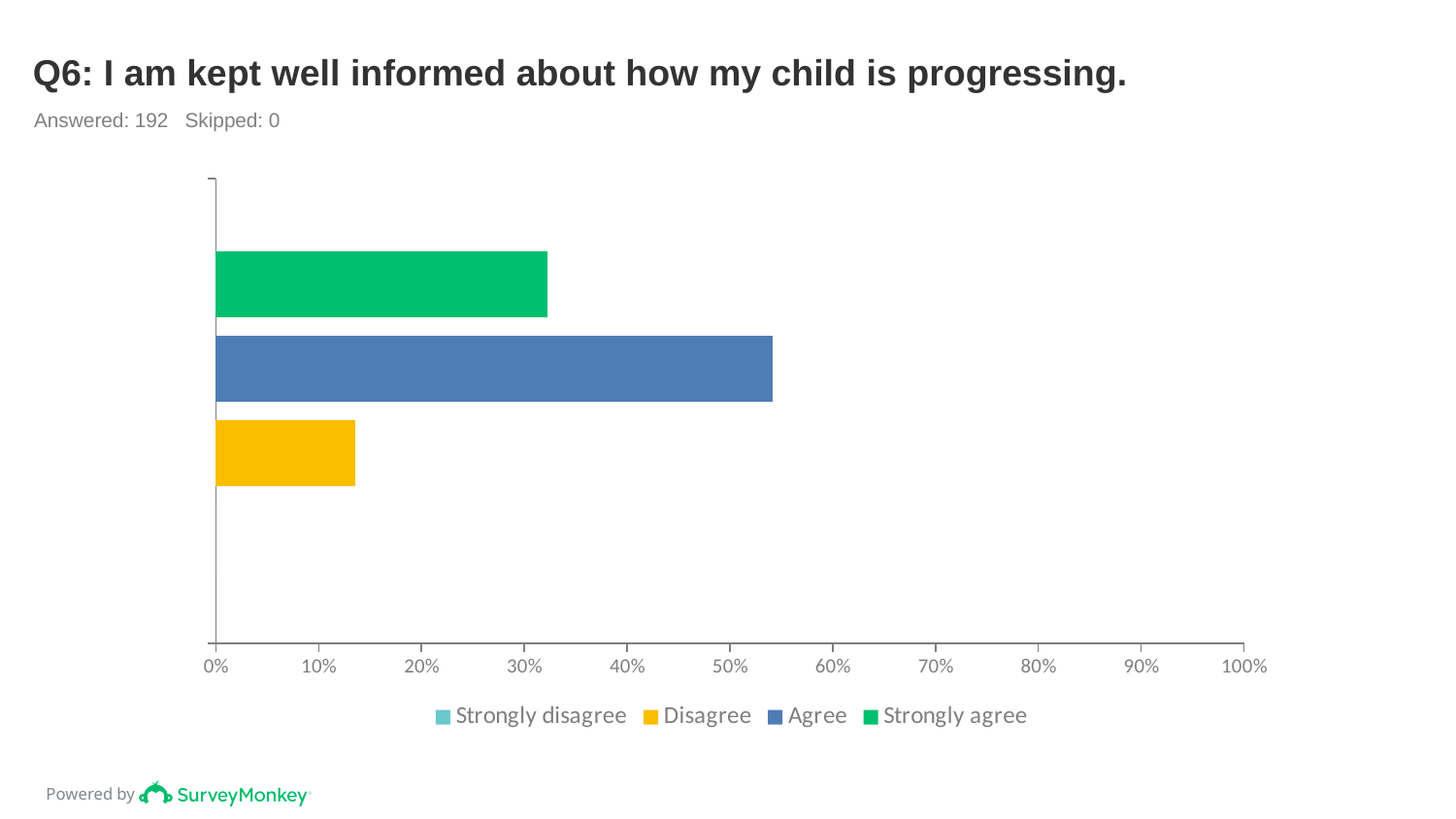
Which response has the longest bar? Agree Is the value for Strongly agree greater or less than 40%? less Which is larger, the value for Strongly agree or the value for Disagree? Strongly agree How many series does the legend list? 4 How many responses were answered according to the slide? 192 Which is larger, the value for Agree or the value for Strongly agree? Agree What kind of chart is shown on the slide? bar chart Is the value for Agree greater or less than 60%? less Is the value for Disagree greater or less than 20%? less Which of the visible bars is the shortest? Disagree What is the title of the chart? Q6: I am kept well informed about how my child is progressing.